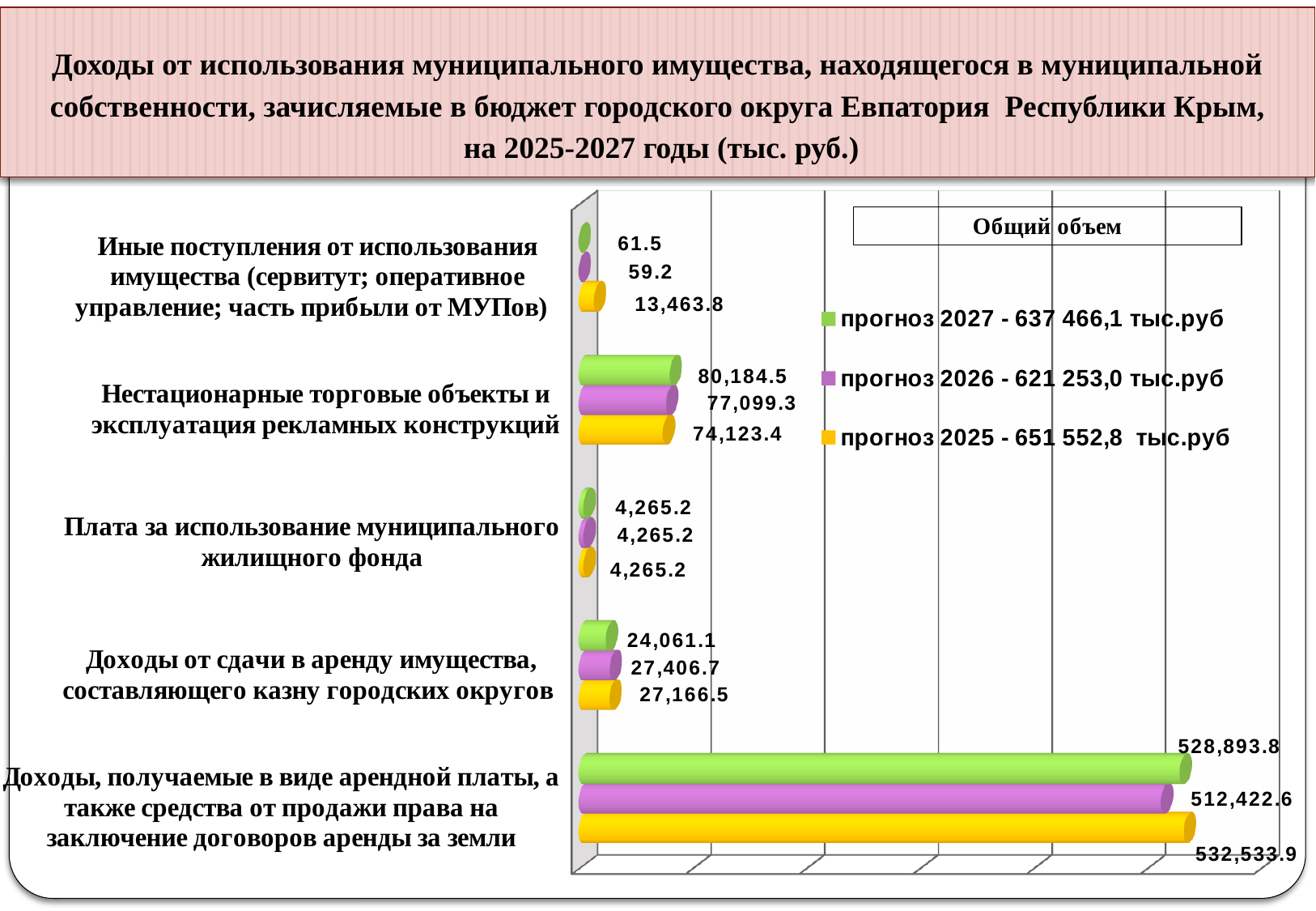
What is the difference between the прогноз 2025 and прогноз 2026 values for 'Доходы, получаемые в виде арендной платы, а также средства от продажи права на заключение договоров аренды за земли'? 20,111.3 How many categories are plotted on the chart? 5 According to the legend, what is the total volume (Общий объем) for прогноз 2025? 651 552,8 тыс.руб What is the прогноз 2026 value for 'Доходы от сдачи в аренду имущества, составляющего казну городских округов'? 27,406.7 What is the difference between the прогноз 2027 and прогноз 2025 values for 'Нестационарные торговые объекты и эксплуатация рекламных конструкций'? 6,061.1 How many series does the legend list? 3 Which category has the lowest прогноз 2027 value? Иные поступления от использования имущества (сервитут; оперативное управление; часть прибыли от МУПов) What is the прогноз 2025 value for 'Иные поступления от использования имущества (сервитут; оперативное управление; часть прибыли от МУПов)'? 13,463.8 What type of chart is shown on the slide? bar chart Which category has the highest прогноз 2025 value? Доходы, получаемые в виде арендной платы, а также средства от продажи права на заключение договоров аренды за земли What is the прогноз 2027 value for 'Нестационарные торговые объекты и эксплуатация рекламных конструкций'? 80,184.5 For 'Доходы от сдачи в аренду имущества, составляющего казну городских округов', which is larger: the прогноз 2026 value or the прогноз 2027 value? прогноз 2026